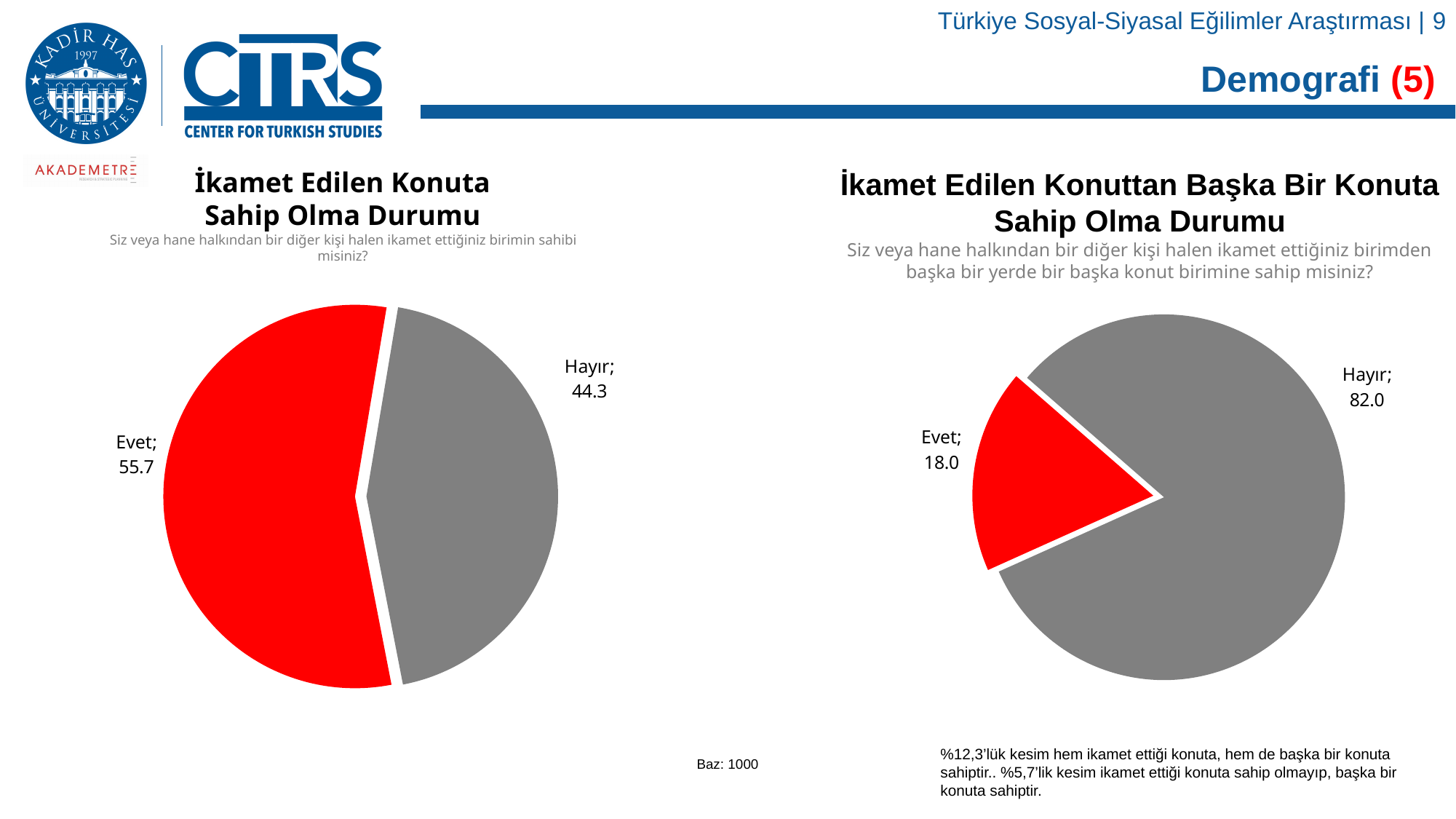
In the left pie chart 'İkamet Edilen Konuta Sahip Olma Durumu', what is the value for Evet? 55.7 What is the base (Baz) sample size shown on the slide? 1000 In the left pie chart 'İkamet Edilen Konuta Sahip Olma Durumu', what is the value for Hayır? 44.3 In the left pie chart, what is the difference between the Evet and Hayır values? 11.4 In the right pie chart 'İkamet Edilen Konuttan Başka Bir Konuta Sahip Olma Durumu', what is the value for Evet? 18.0 What type of chart is used on the left side of the slide? Pie chart In the right pie chart, what is the difference between the Hayır and Evet values? 64.0 In the right pie chart, what colour is the Evet slice? Red How many slices does the right pie chart have? 2 In the right pie chart 'İkamet Edilen Konuttan Başka Bir Konuta Sahip Olma Durumu', what is the value for Hayır? 82.0 In the right pie chart, which slice is the smallest? Evet In the left pie chart, which slice is larger, Evet or Hayır? Evet